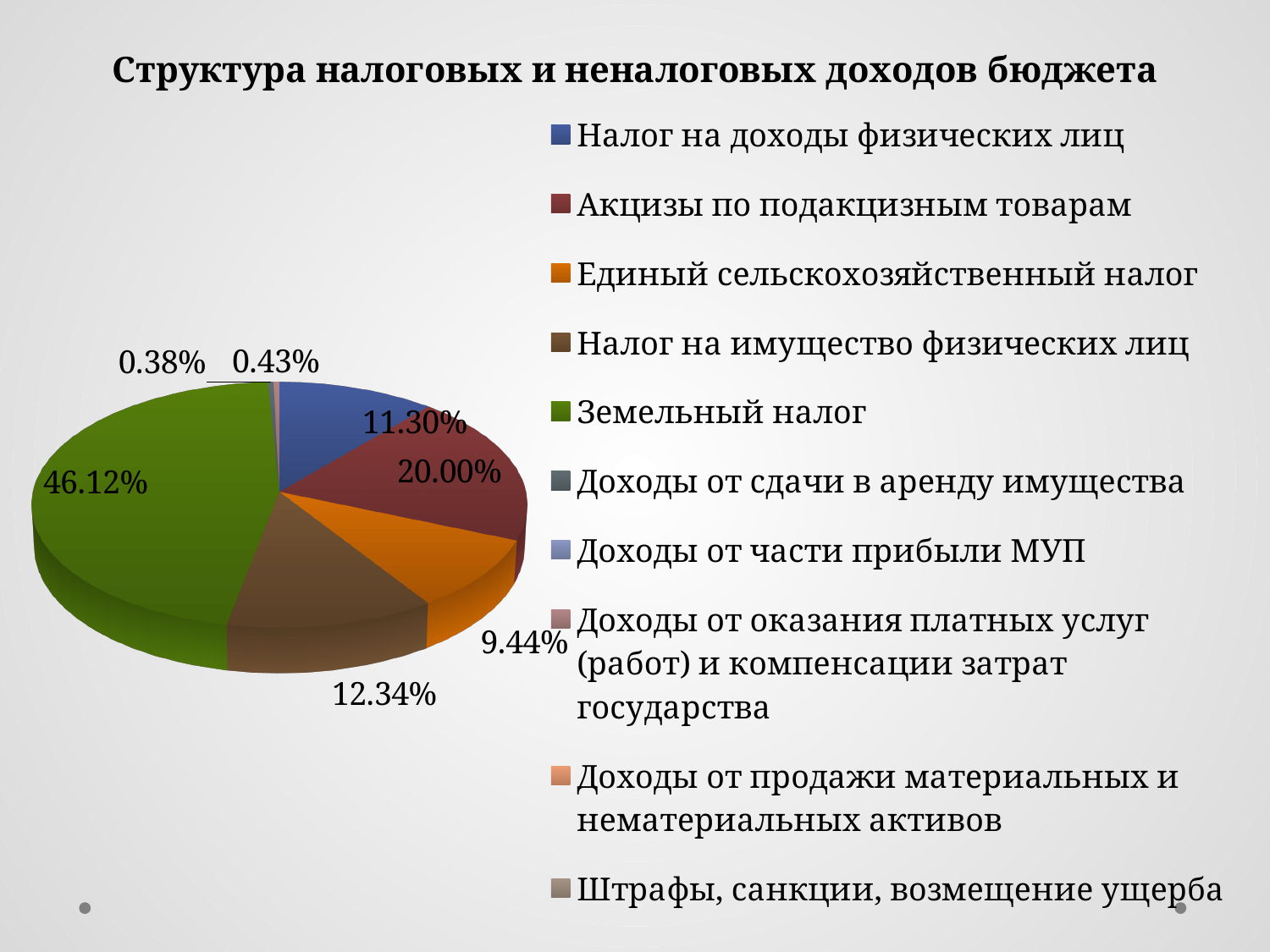
Which is larger: Акцизы по подакцизным товарам or Налог на имущество физических лиц? Акцизы по подакцизным товарам What share of the pie does Акцизы по подакцизным товарам have? 20.00% What share of the pie does Земельный налог have? 46.12% What is the difference between the shares of Земельный налог and Акцизы по подакцизным товарам? 26.12% What is the title of the chart? Структура налоговых и неналоговых доходов бюджета What kind of chart is shown on the slide? Pie chart Which category has the largest slice of the pie? Земельный налог What share of the pie does Налог на имущество физических лиц have? 12.34% What share of the pie does Единый сельскохозяйственный налог have? 9.44% How many entries does the legend list? 10 What colour is the slice for Земельный налог? Green What share of the pie does Налог на доходы физических лиц have? 11.30%